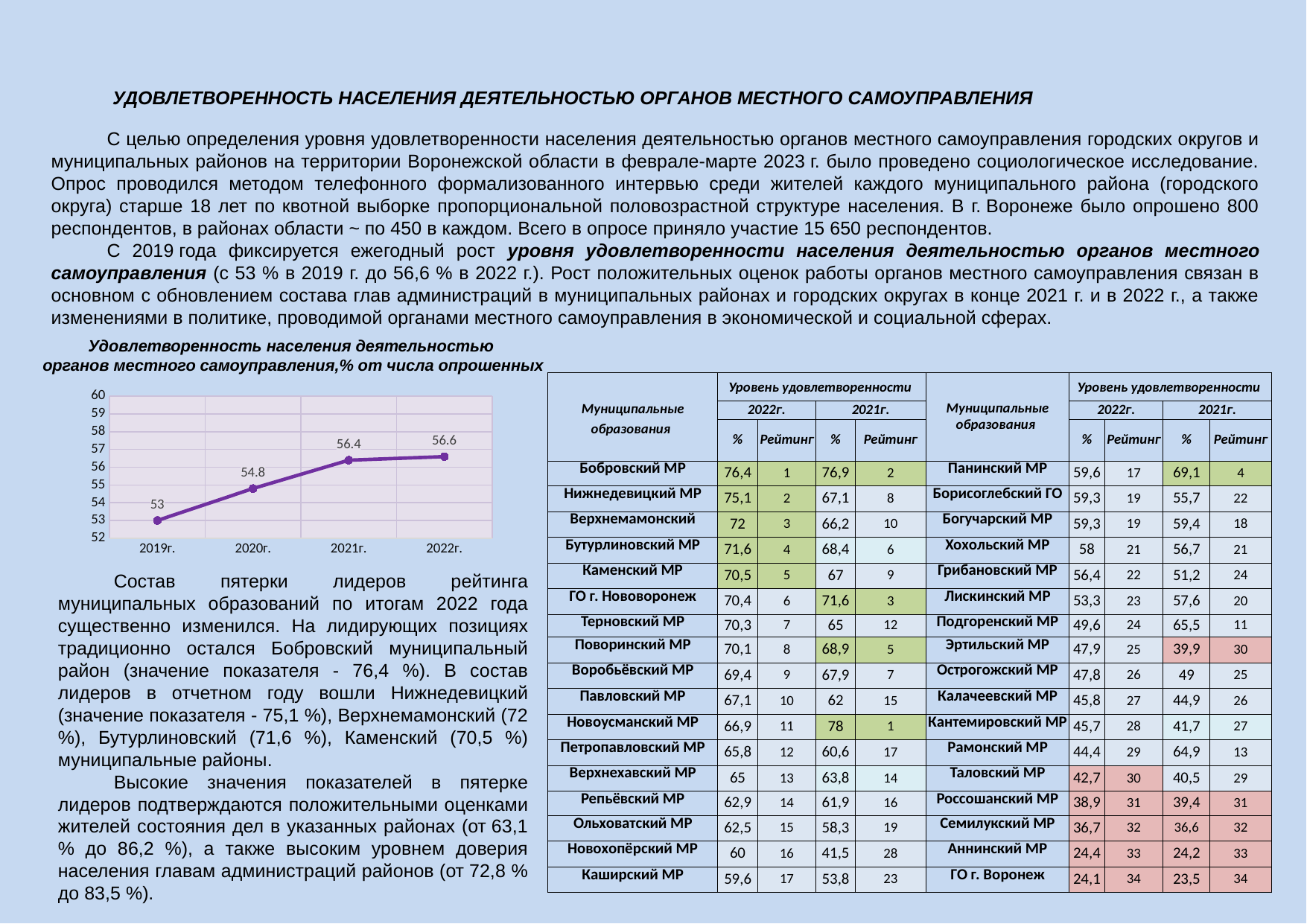
Which year has the lowest value on the chart? 2019г. What is the value plotted for 2021г.? 56.4 What is the value plotted for 2019г.? 53 What is the difference between the values for 2022г. and 2019г.? 3.6 How many years are plotted on the chart? 4 What type of chart is shown on the slide? line chart Is the value for 2020г. greater or less than 55? less Which is larger, the value for 2020г. or the value for 2021г.? 2021г. What is the value plotted for 2020г.? 54.8 What is the value plotted for 2022г.? 56.6 Do the values rise or fall from 2019г. to 2022г.? rise Which year has the highest value on the chart? 2022г.